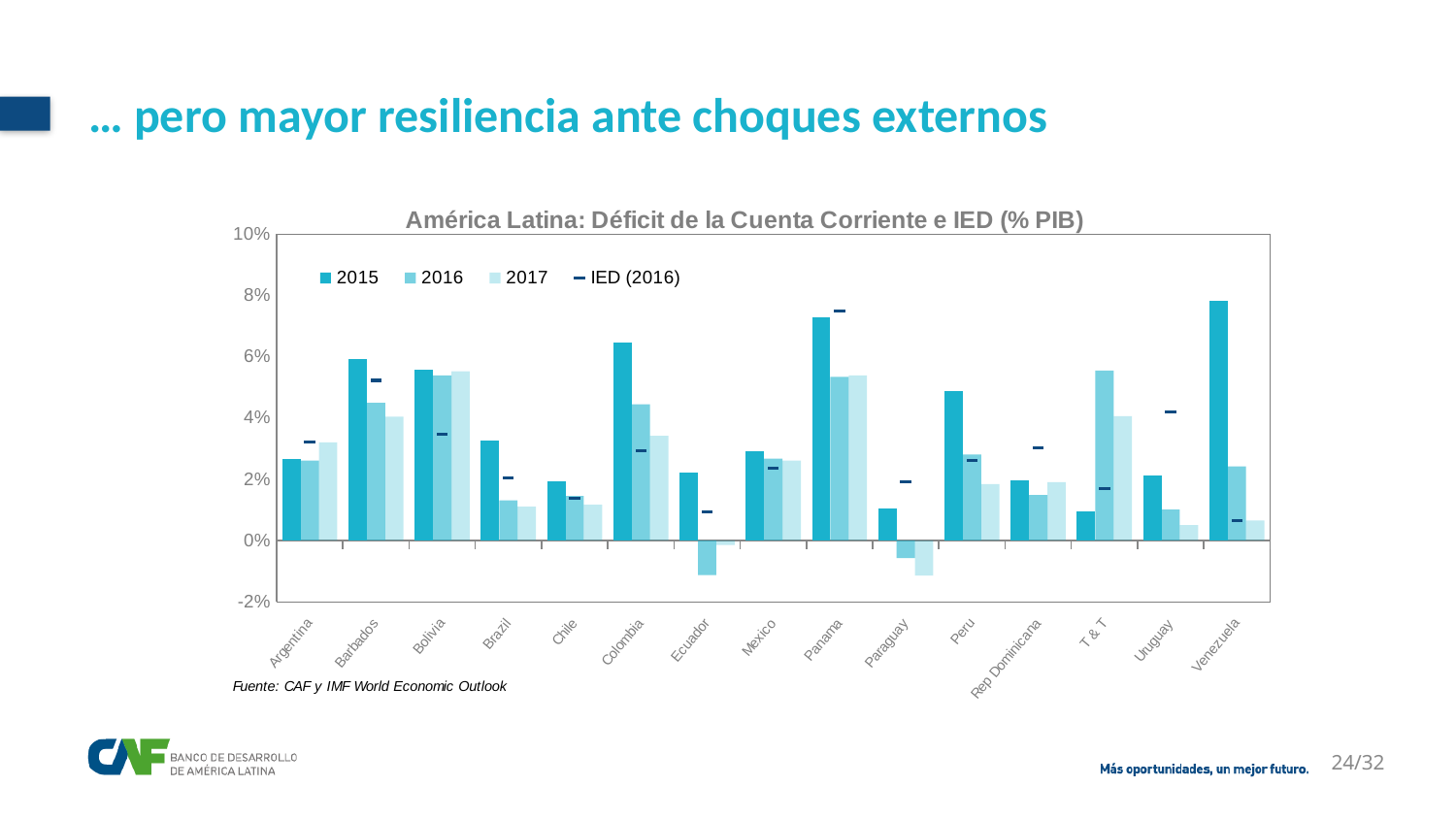
How many entries does the chart's legend list? 4 What kind of chart is shown on the slide? bar chart How many countries are shown on the x axis of the chart? 15 Is the 2015 value for Colombia greater or less than 6%? greater Which is larger, the 2015 value for Bolivia or the 2015 value for Brazil? Bolivia Is the 2016 value for T & T greater or less than 4%? greater Which country has the lowest 2017 bar? Paraguay For T & T, which is larger, the 2015 value or the 2016 value? 2016 Is the 2016 value for Ecuador greater or less than 0%? less Which country has the lowest 2016 bar? Ecuador What is the title of the chart? América Latina: Déficit de la Cuenta Corriente e IED (% PIB) Which country has the highest 2015 bar? Venezuela